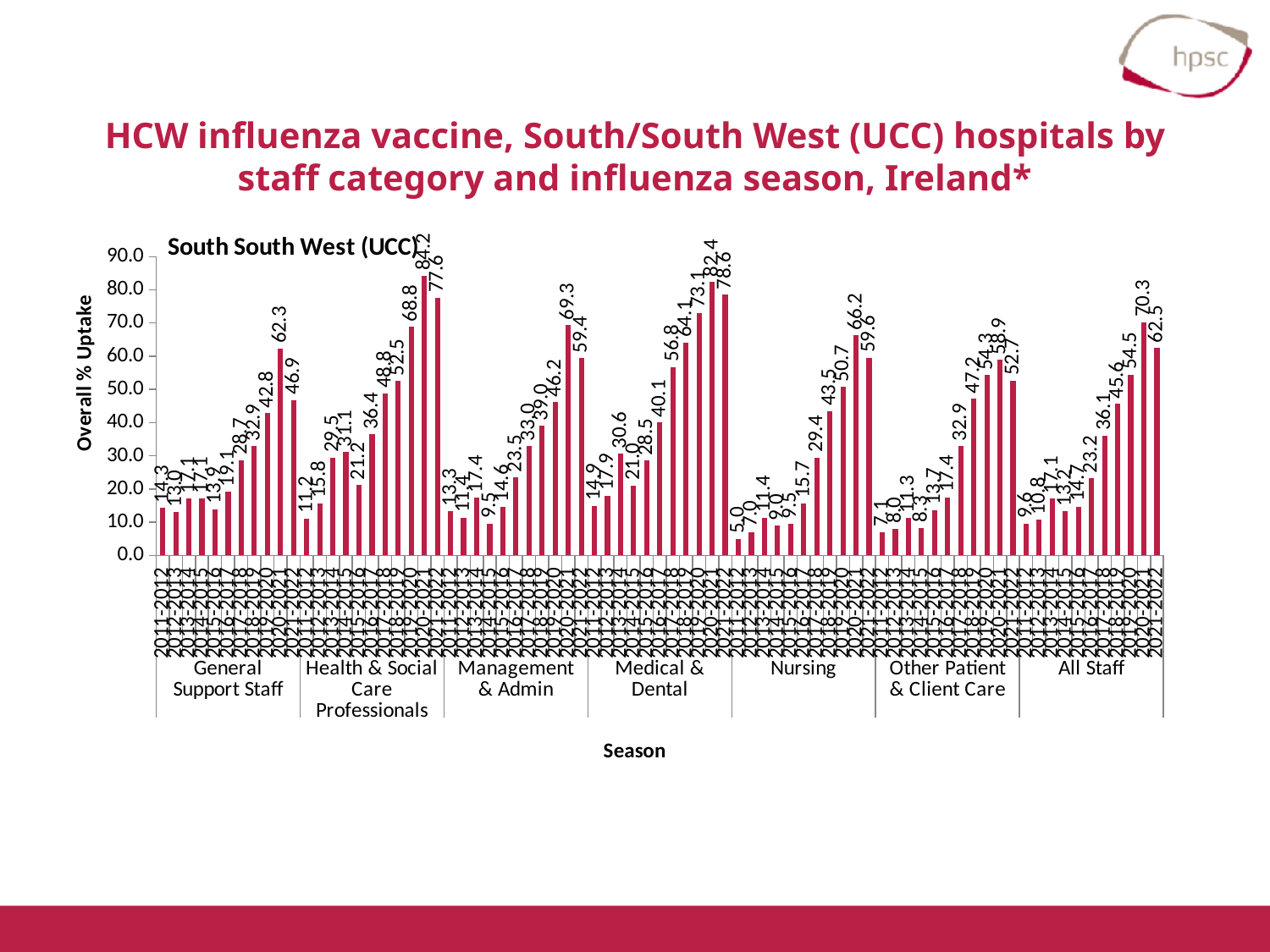
What is the label on the vertical axis of the chart? Overall % Uptake Which staff category has the highest single bar in the chart? Health & Social Care Professionals What type of chart is shown on the slide? bar chart What is the overall % uptake for All Staff in the 2021-2022 season? 62.5 What is the overall % uptake for Medical & Dental in the 2020-2021 season? 82.4 What is the difference between the All Staff values for 2020-2021 and 2021-2022? 7.8 How many staff categories are shown along the x axis of the chart? 7 Which is larger: the 2020-2021 value for Health & Social Care Professionals or the 2020-2021 value for Medical & Dental? Health & Social Care Professionals What is the overall % uptake for Nursing in the 2020-2021 season? 66.2 Is the value for Nursing in 2021-2022 greater or less than 50.0? greater What is the lowest value shown in the chart, and for which staff category? 5.0, Nursing Do the All Staff values generally rise or fall from 2011-2012 to 2020-2021? rise